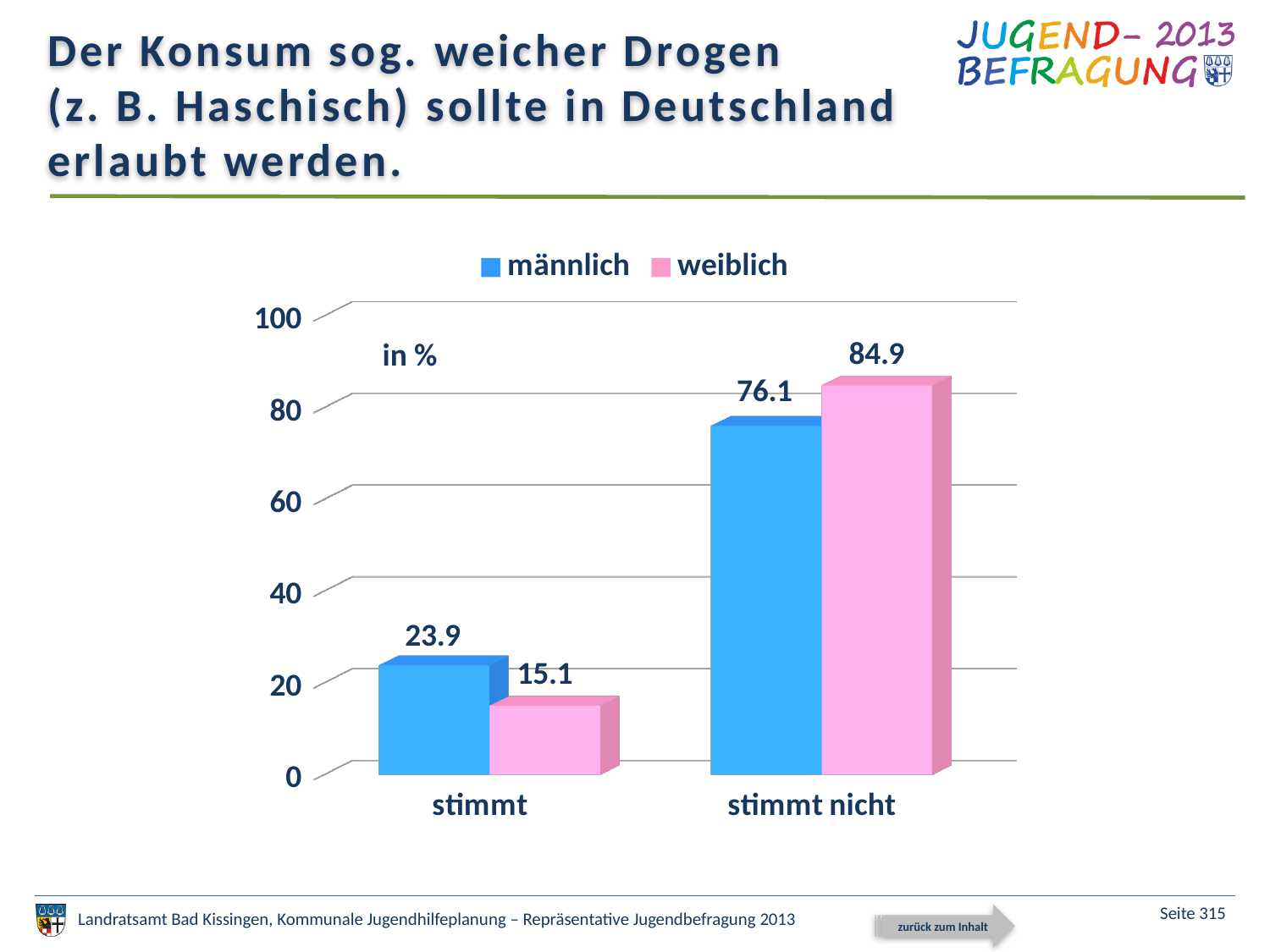
What is the value for männlich in the stimmt category? 23.9 How many categories are shown on the x axis? 2 What is the difference between the weiblich and männlich values in the stimmt nicht category? 8.8 What is the value for weiblich in the stimmt nicht category? 84.9 How many series does the legend list? 2 Which bar has the highest value on the chart? weiblich, stimmt nicht What is the value for männlich in the stimmt nicht category? 76.1 Which bar has the lowest value on the chart? weiblich, stimmt Is the value for männlich in the stimmt nicht category greater or less than 60? greater In the stimmt category, which series has the larger value, männlich or weiblich? männlich What kind of chart is shown on the slide? bar chart What is the value for weiblich in the stimmt category? 15.1